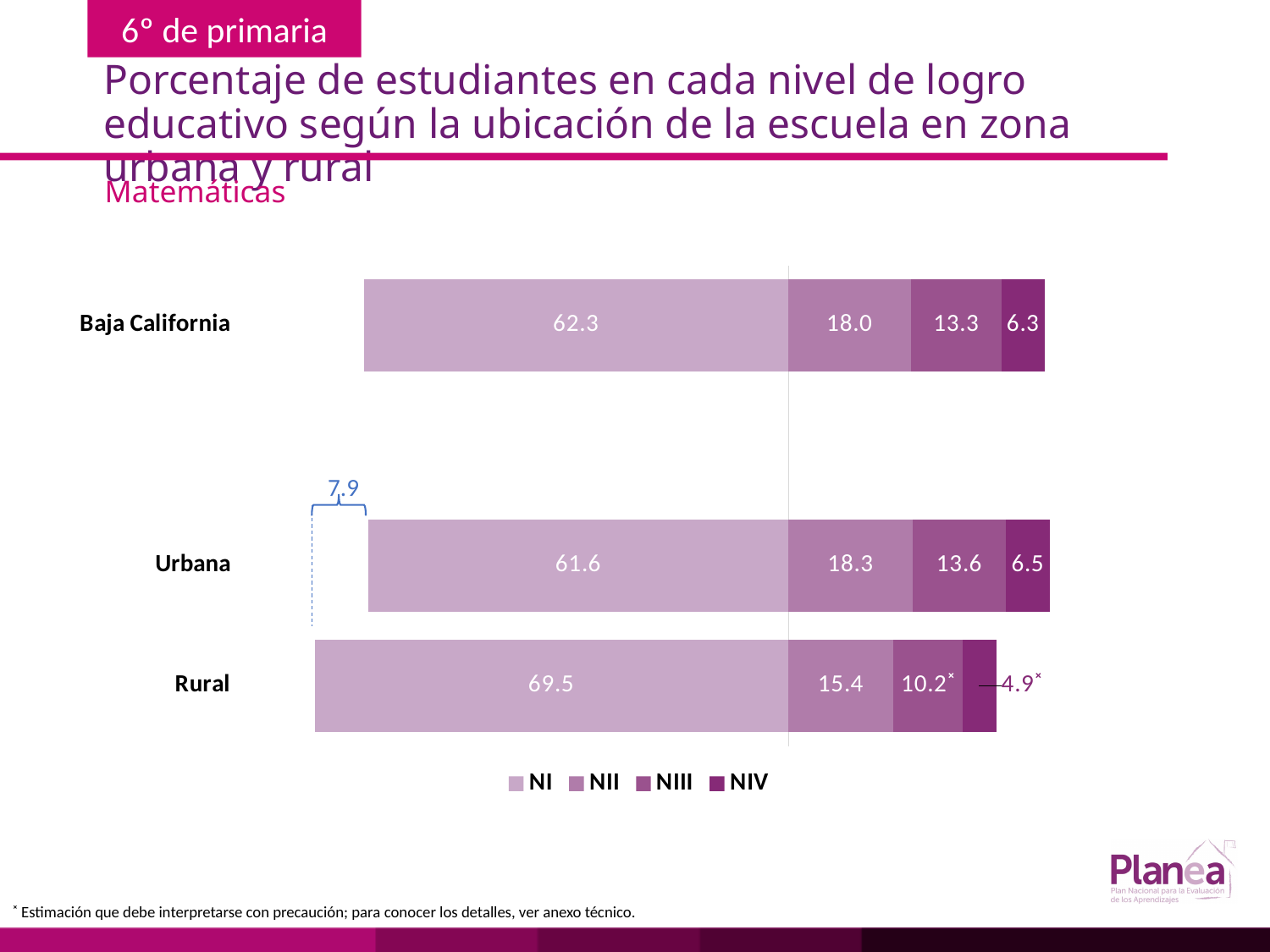
What type of chart is shown on the slide? Stacked bar chart What is the total of the stacked bar for Urbana? 100.0 Which category has the highest NI value? Rural What is the NI value for Rural? 69.5 What is the difference between the NI values for Rural and Urbana? 7.9 Which is larger, the NII value for Urbana or the NII value for Rural? Urbana What is the NIV value for Urbana? 6.5 How many categories are plotted on the chart? 3 What is the NII value for Baja California? 18.0 What is the NIII value for Rural? 10.2 How many series does the legend list? 4 Which category has the lowest NIV value? Rural